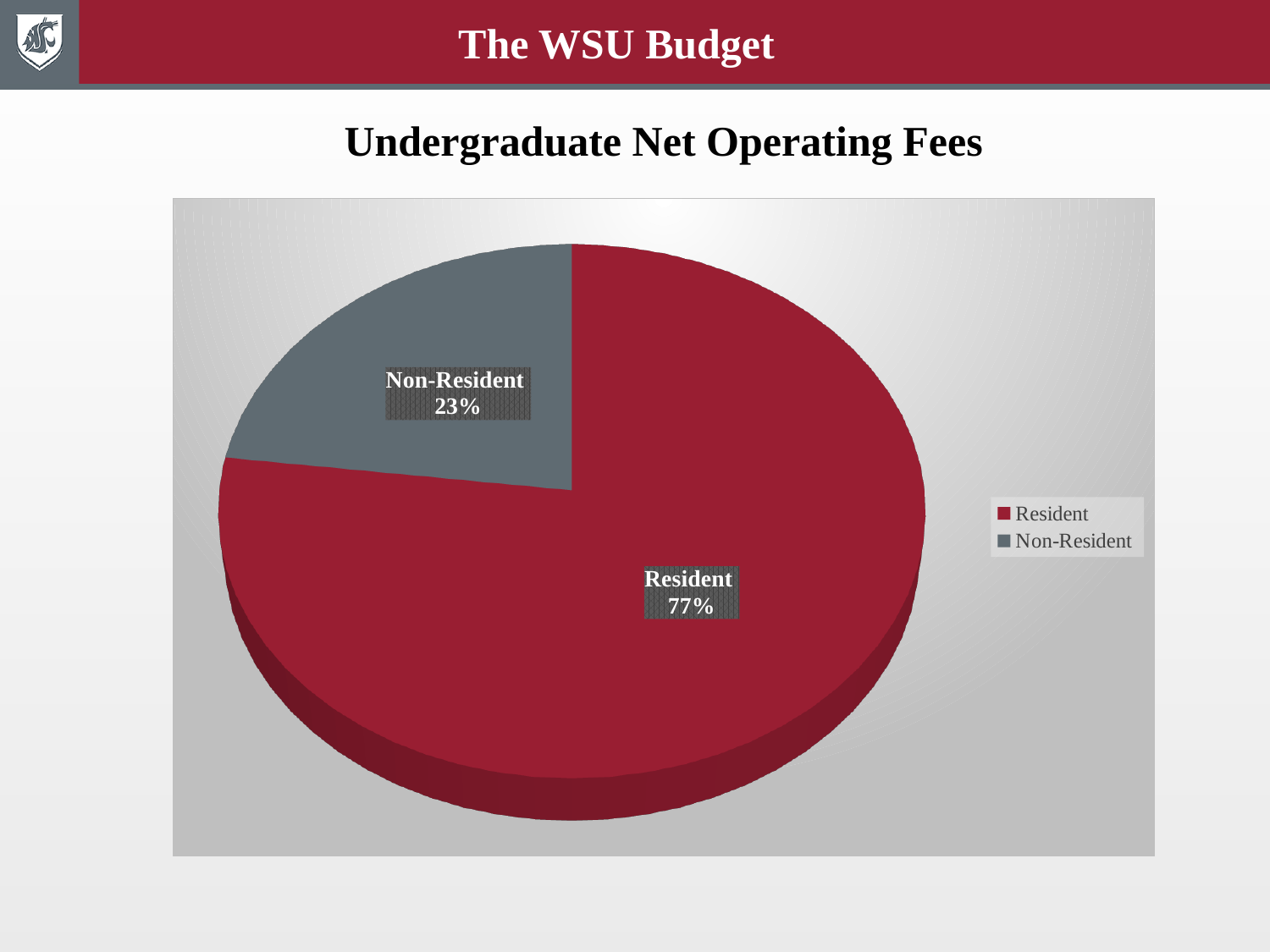
What share of Undergraduate Net Operating Fees comes from Non-Resident students? 23% By how many percentage points does the Resident share exceed the Non-Resident share? 54 Which category has the largest slice of the pie? Resident What share of Undergraduate Net Operating Fees comes from Resident students? 77% What is the title of the chart? Undergraduate Net Operating Fees Which is larger, the Resident share or the Non-Resident share? Resident Which category has the smallest slice of the pie? Non-Resident What colour is the Non-Resident slice? Grey What kind of chart is shown on the slide? Pie chart How many entries does the legend list? 2 How many slices does the pie chart have? 2